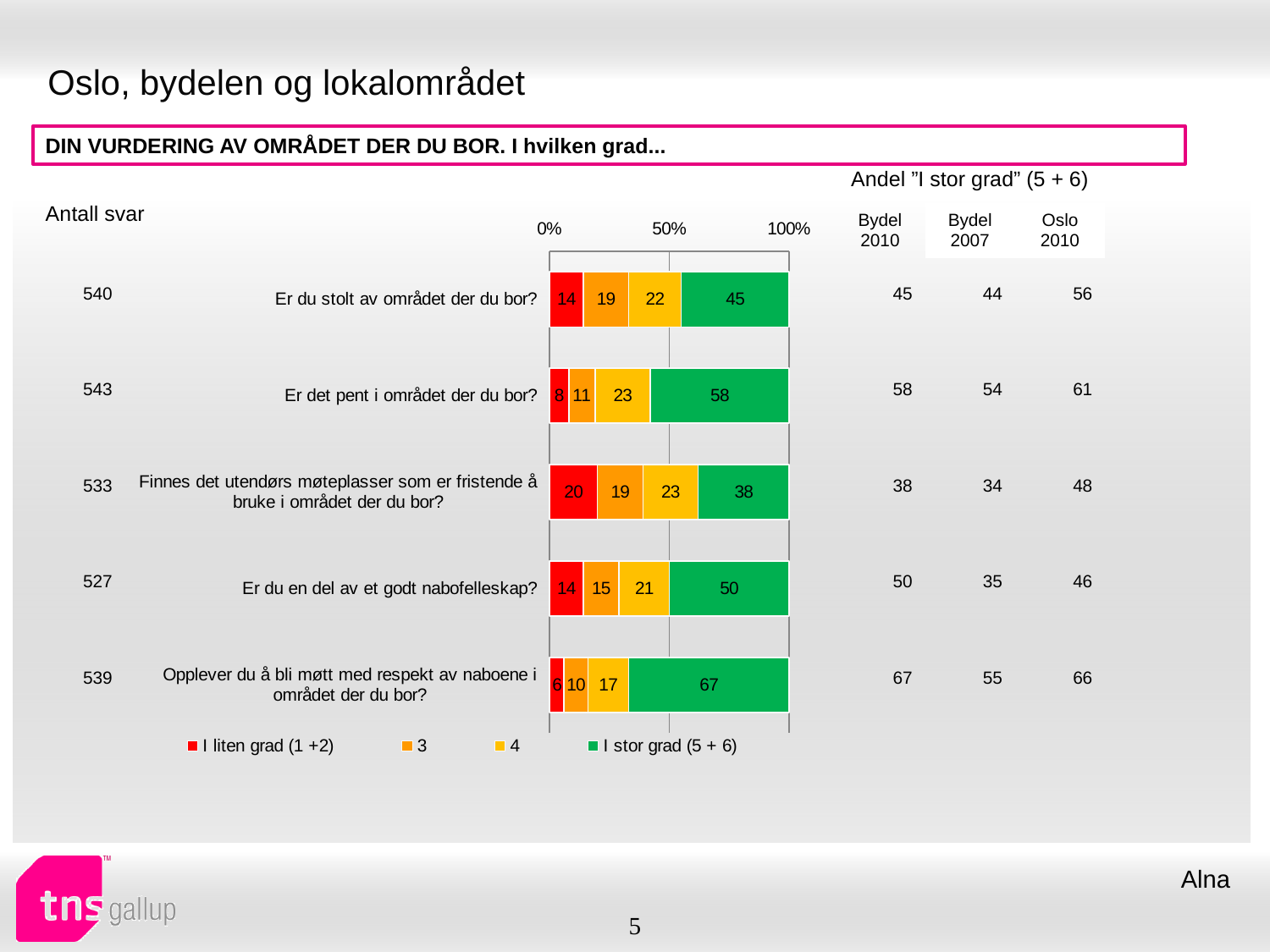
What is the value of "I liten grad (1 +2)" for "Finnes det utendørs møteplasser som er fristende å bruke i området der du bor?"? 20 What is the value of "I stor grad (5 + 6)" for "Er du stolt av området der du bor?"? 45 How many questions (categories) are shown in the bar chart? 5 Which question has the lowest "I stor grad (5 + 6)" value? Finnes det utendørs møteplasser som er fristende å bruke i området der du bor? Which colour represents "I stor grad (5 + 6)" in the chart? Green Which question has the highest "I stor grad (5 + 6)" value? Opplever du å bli møtt med respekt av naboene i området der du bor? What type of chart is shown on the slide? Stacked bar chart How many series does the legend list? 4 What is the total of the stacked bar for "Er du en del av et godt nabofelleskap?"? 100 What is the difference between the "I stor grad (5 + 6)" values for "Opplever du å bli møtt med respekt av naboene i området der du bor?" and "Er du stolt av området der du bor?"? 22 What is the value of the "4" segment for "Er det pent i området der du bor?"? 23 Which has a larger "I liten grad (1 +2)" value: "Er det pent i området der du bor?" or "Er du en del av et godt nabofelleskap?"? Er du en del av et godt nabofelleskap?